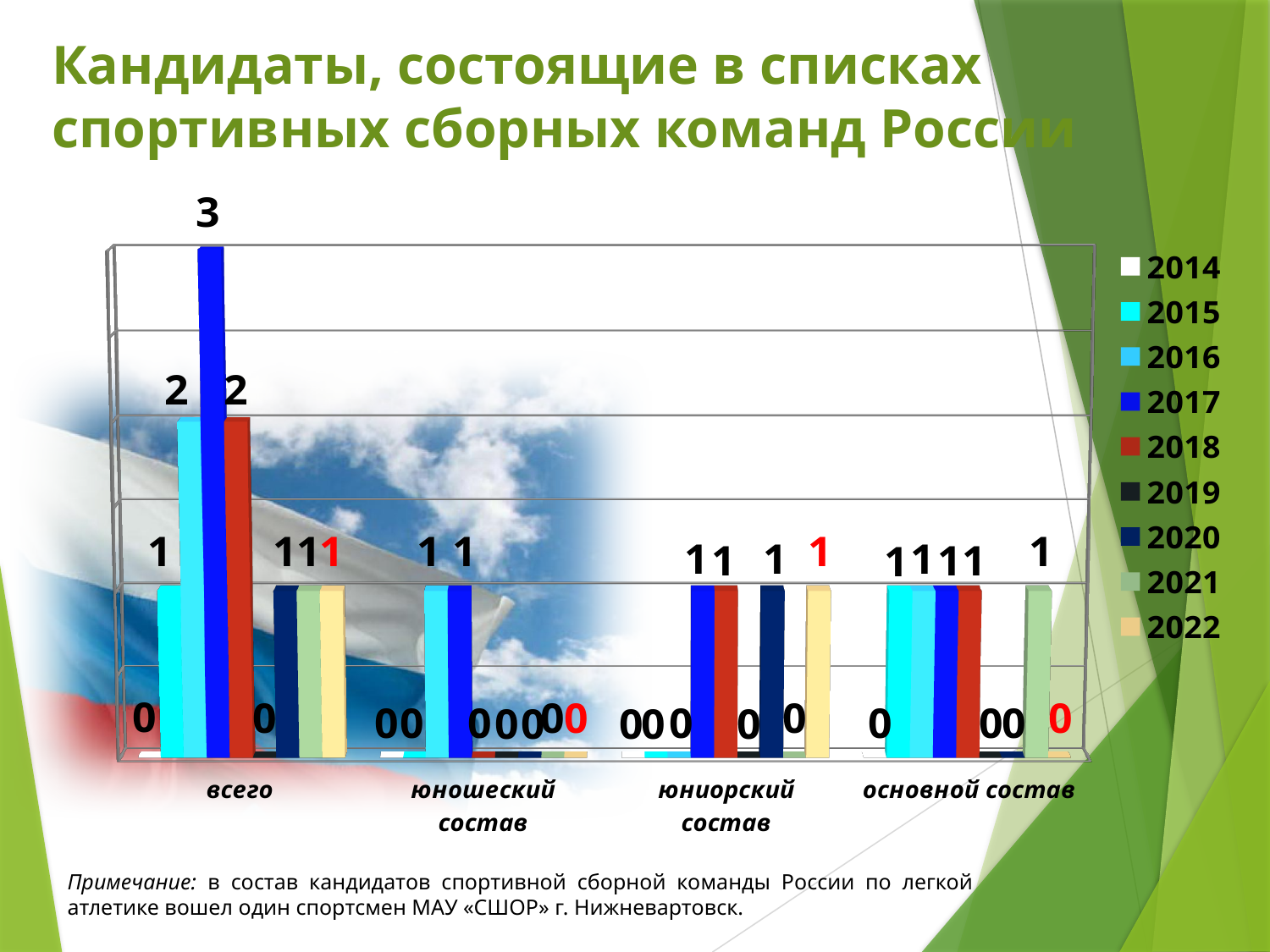
What is the value for 2017 in the "юношеский состав" category? 1 What is the value for 2015 in the "всего" category? 1 What is the difference between the 2017 and 2015 values in the "всего" category? 2 What kind of chart is shown on the slide? bar chart In the "всего" category, which is larger: the value for 2016 or the value for 2015? 2016 How many series does the legend list? 9 How many categories are shown along the x axis? 4 What is the value for 2014 in the "основной состав" category? 0 What is the value for 2017 in the "всего" category? 3 Which year has the highest value in the "всего" category? 2017 Which year is shown in red in the legend? 2018 What is the value for 2016 in the "всего" category? 2